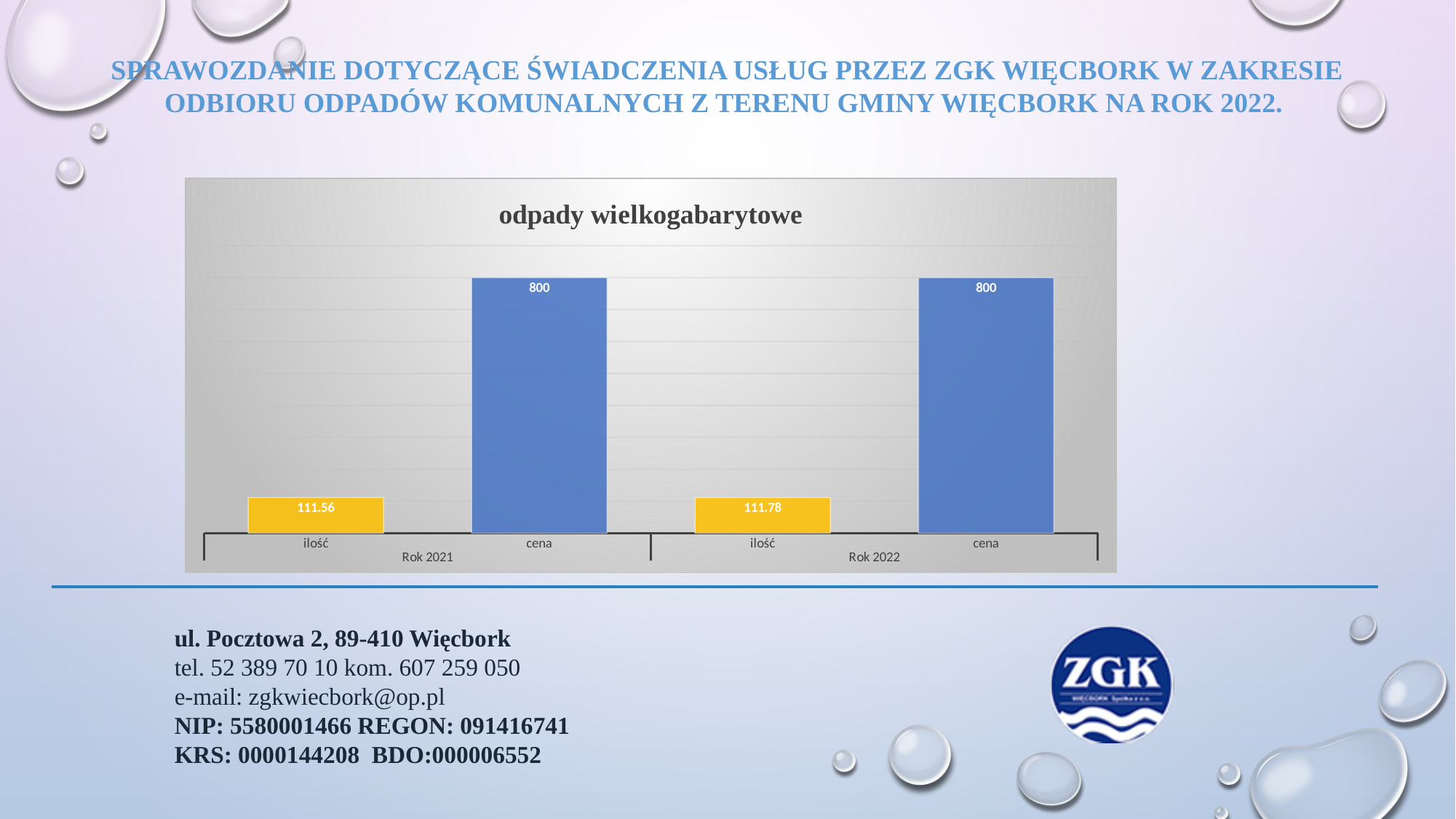
What is the value of cena for Rok 2022? 800 How many years are shown on the x axis of the chart? 2 What type of chart is shown on the slide? bar chart What is the difference between cena and ilość for Rok 2021? 688.44 What is the value of ilość for Rok 2021? 111.56 What is the value of cena for Rok 2021? 800 What is the title of the chart? odpady wielkogabarytowe What is the difference between ilość for Rok 2022 and ilość for Rok 2021? 0.22 How many bars are plotted in the chart? 4 Which is larger for Rok 2022, ilość or cena? cena What is the value of ilość for Rok 2022? 111.78 What colour are the cena bars in the chart? blue